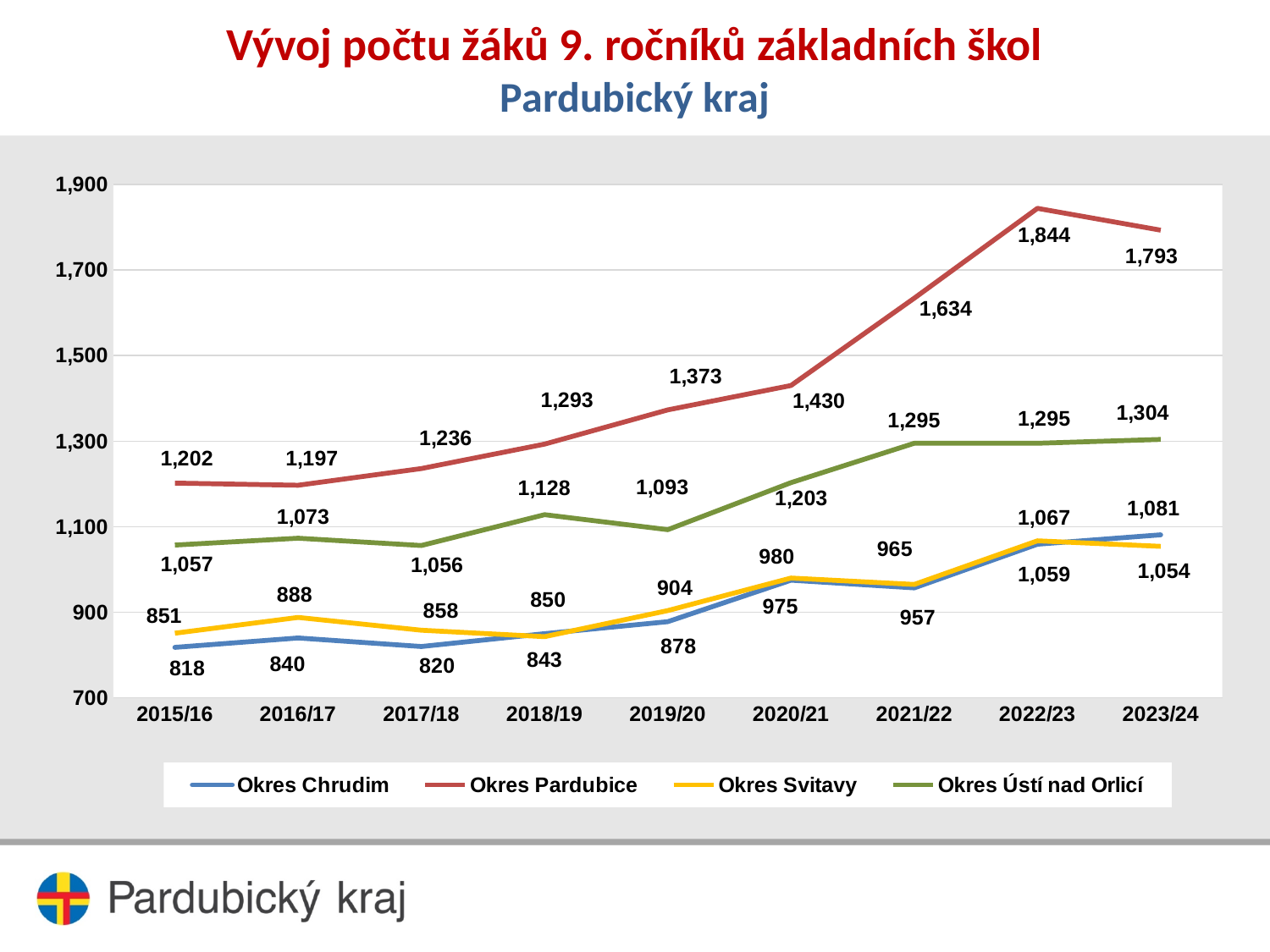
What is the value for Okres Svitavy in 2019/20? 904 Does the value for Okres Pardubice generally rise or fall from 2015/16 to 2022/23? rise What is the difference between Okres Pardubice and Okres Ústí nad Orlicí in 2023/24? 489 How many school years are shown on the x axis? 9 What is the value for Okres Chrudim in 2015/16? 818 What is the value for Okres Ústí nad Orlicí in 2020/21? 1,203 In which school year does Okres Chrudim have its lowest value? 2015/16 Which series has the higher value in 2023/24, Okres Chrudim or Okres Svitavy? Okres Chrudim What type of chart is shown on the slide? line chart What is the value for Okres Pardubice in 2022/23? 1,844 In which school year does Okres Pardubice reach its highest value? 2022/23 How many series does the legend list? 4